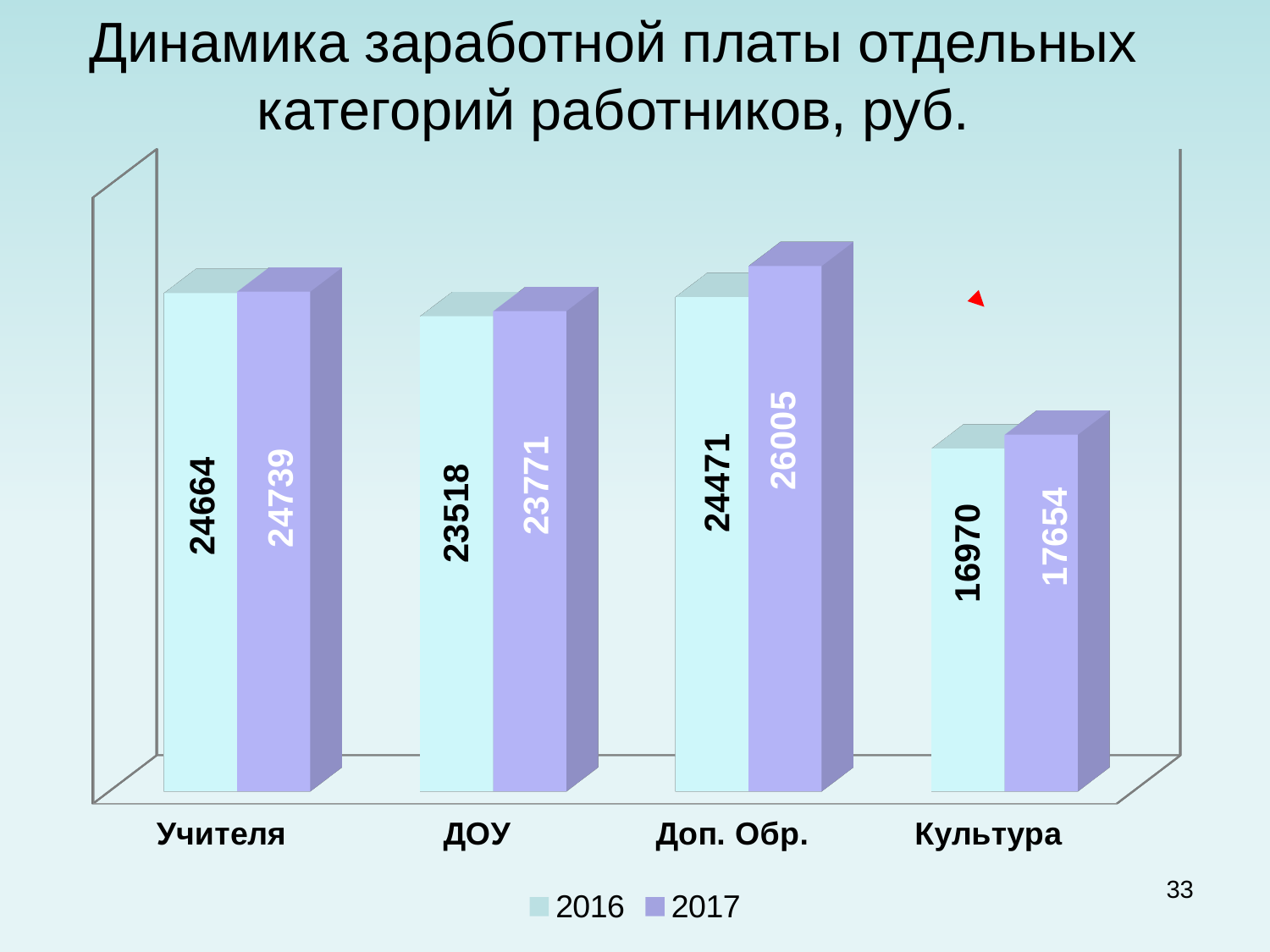
What is the 2016 value for Культура? 16970 Which category has the highest 2017 value? Доп. Обр. What is the 2017 value for Доп. Обр.? 26005 What is the difference between the 2017 and 2016 values for Доп. Обр.? 1534 How many series does the legend list? 2 What is the 2016 value for Учителя? 24664 Which is larger: the 2016 value for Учителя or the 2016 value for ДОУ? Учителя What kind of chart is shown on the slide? Bar chart Which category has the lowest 2016 value? Культура What is the 2017 value for ДОУ? 23771 What is the difference between the 2017 and 2016 values for Культура? 684 How many categories are shown on the x axis? 4